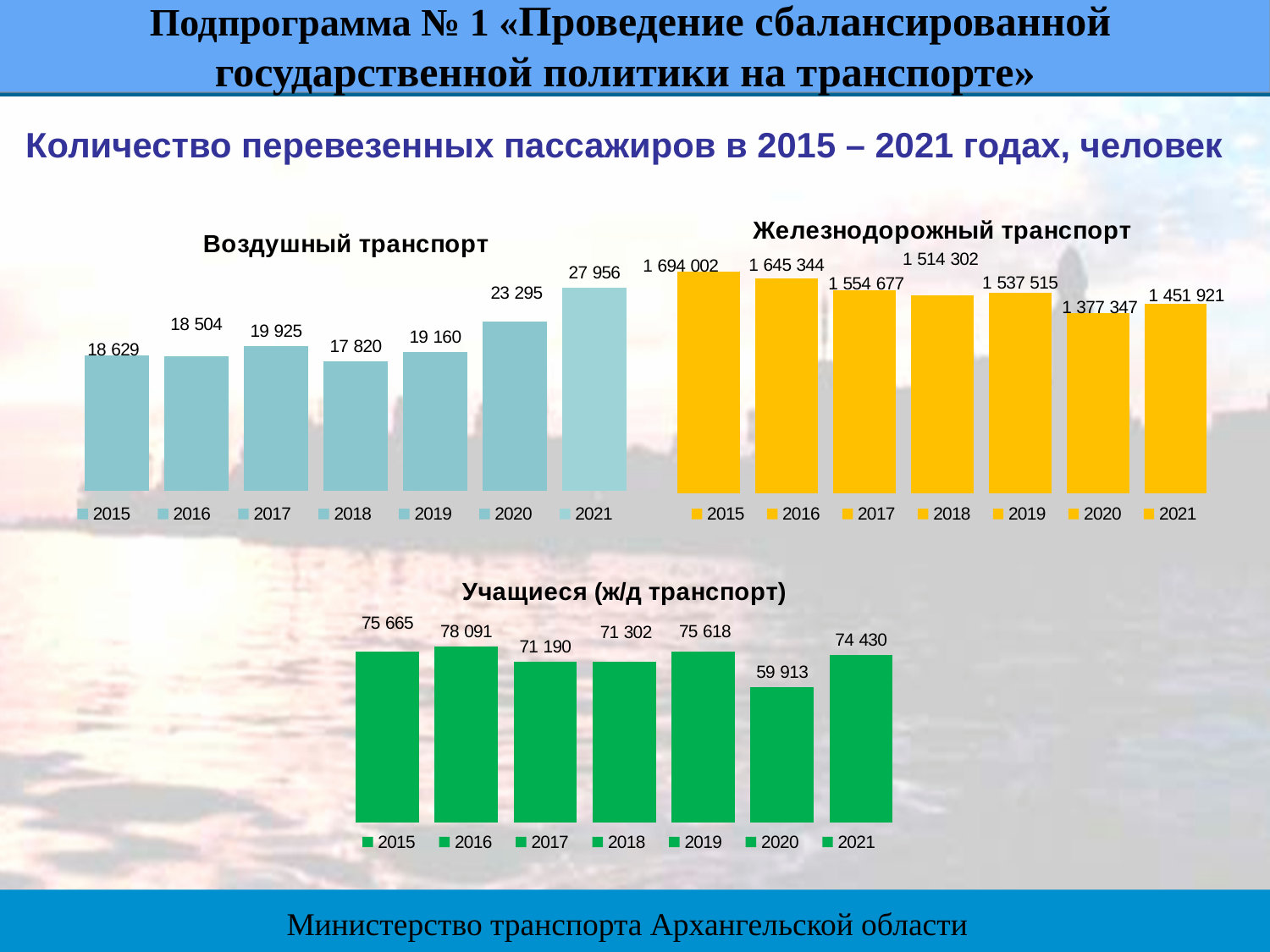
In the 'Учащиеся (ж/д транспорт)' chart, what is the difference between the values for 2016 and 2020? 18 178 In the 'Железнодорожный транспорт' chart, which is larger, the value for 2019 or the value for 2021? 2019 How many bars are shown in the 'Учащиеся (ж/д транспорт)' chart? 7 In the 'Учащиеся (ж/д транспорт)' chart, which year has the highest value? 2016 In the 'Железнодорожный транспорт' chart, which year has the lowest value? 2020 What type of chart is the 'Воздушный транспорт' chart? Bar chart In the 'Воздушный транспорт' chart, what is the difference between the values for 2021 and 2020? 4 661 In the 'Воздушный транспорт' chart, what is the value for 2021? 27 956 In the 'Учащиеся (ж/д транспорт)' chart, what is the value for 2020? 59 913 In the 'Железнодорожный транспорт' chart, what is the value for 2018? 1 514 302 In the 'Железнодорожный транспорт' chart, which year has the highest value? 2015 In the 'Воздушный транспорт' chart, which year has the lowest value? 2018